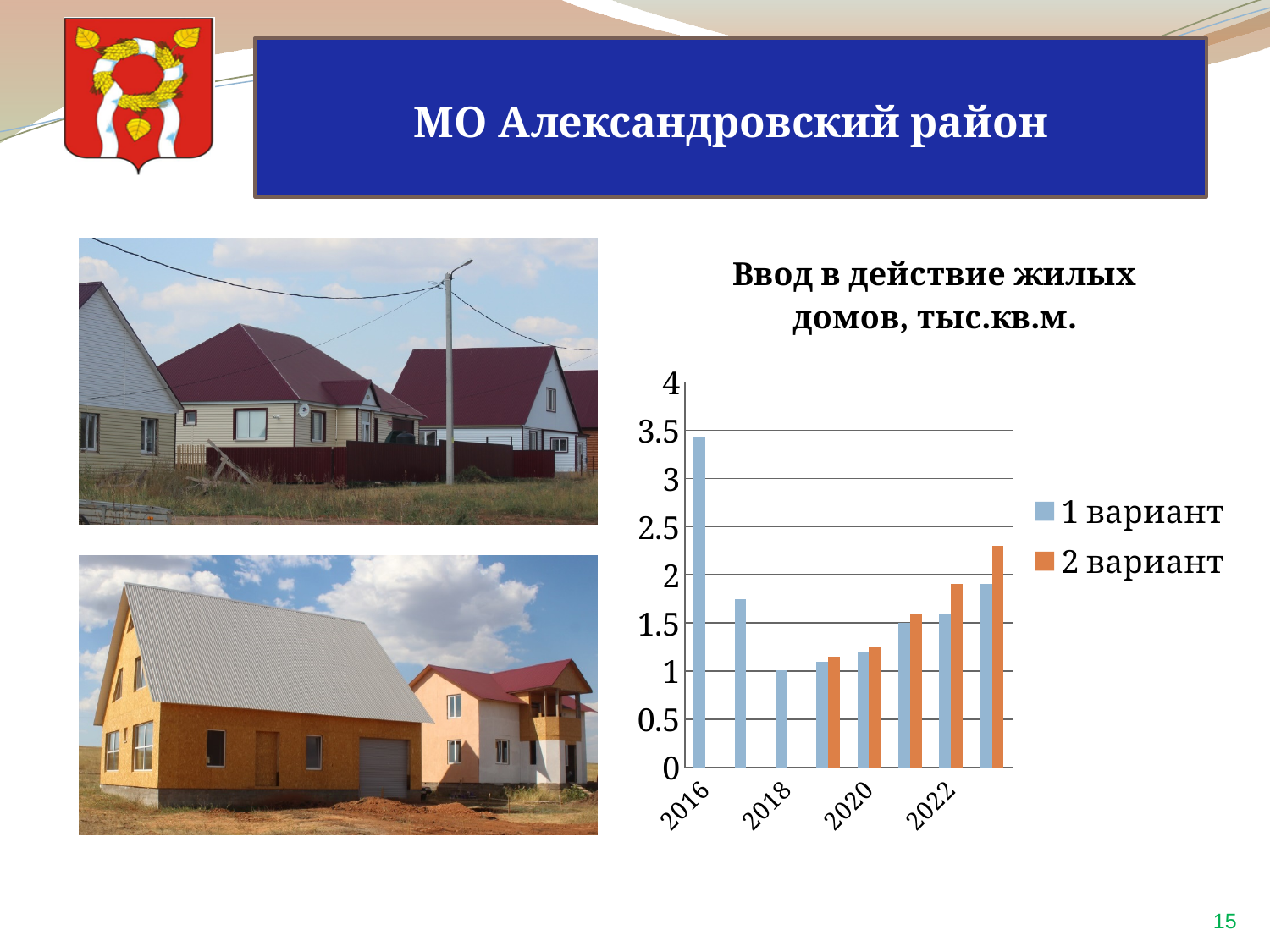
What is the title of the chart? Ввод в действие жилых домов, тыс.кв.м. Is the value for 1 вариант in 2022 greater or less than 2? less Among the labeled years 2016, 2018, 2020 and 2022, in which year is the 1 вариант value lowest? 2018 What kind of chart is shown on the slide? bar chart Is the value for 2 вариант in 2022 greater or less than 2? less In 2022, which series has the larger value, 1 вариант or 2 вариант? 2 вариант Which series is shown in orange in the chart? 2 вариант In which year is the 1 вариант value highest? 2016 Does the 1 вариант value rise or fall from 2016 to 2018? fall Is the value for 1 вариант in 2016 greater or less than 3? greater How many series does the chart legend list? 2